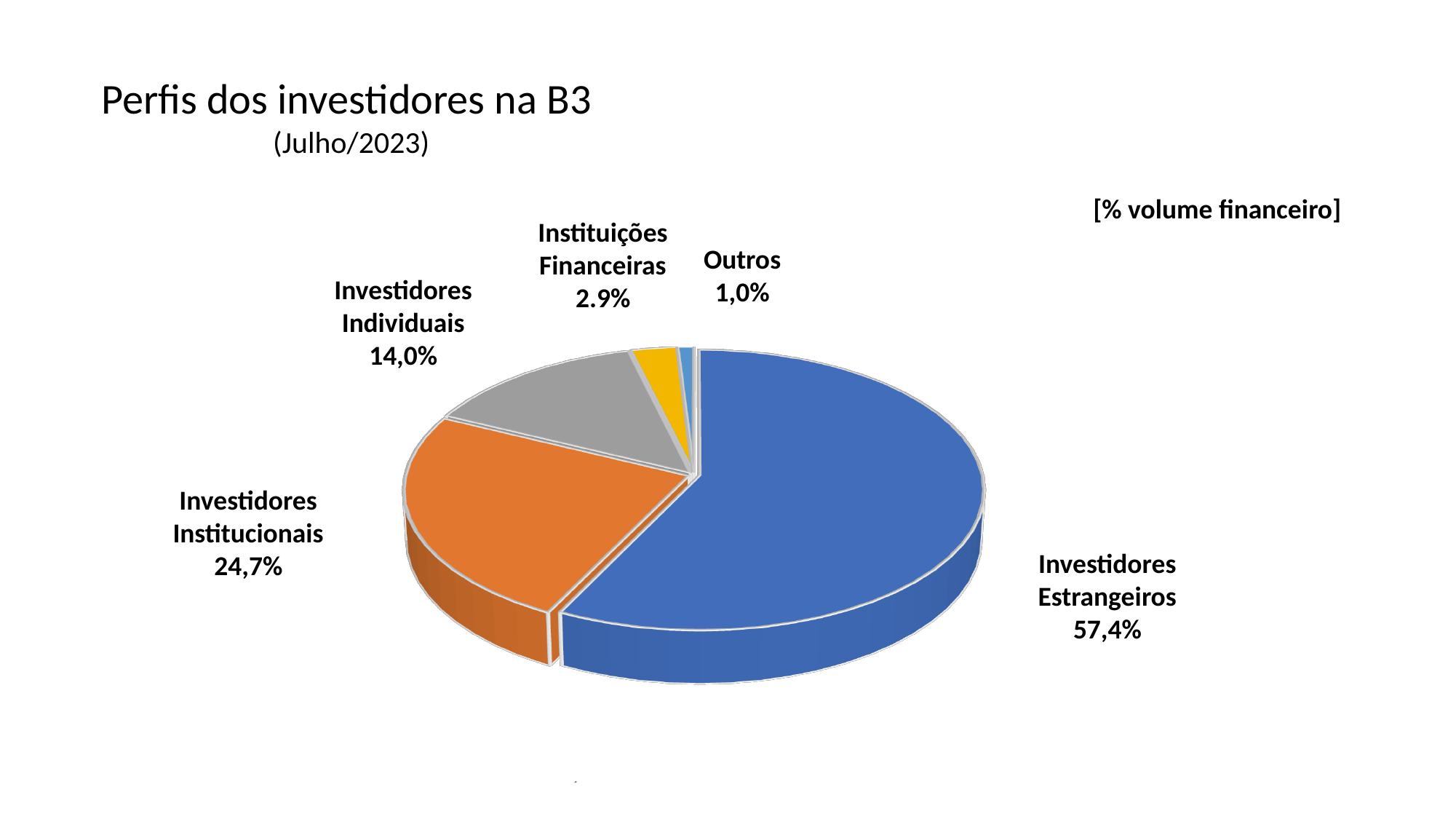
What is the value shown for Investidores Institucionais? 24,7% Which category has the largest slice of the pie? Investidores Estrangeiros What kind of chart is shown on the slide? Pie chart Which category has the smallest slice of the pie? Outros Which is larger, Investidores Institucionais or Investidores Individuais? Investidores Institucionais What is the value shown for Outros? 1,0% What share of the pie does Investidores Estrangeiros hold? 57,4% How many categories are shown in the pie chart? 5 What is the difference in percentage points between Investidores Estrangeiros and Investidores Institucionais? 32,7 What is the value shown for Instituições Financeiras? 2.9% What is the title of the chart? Perfis dos investidores na B3 (Julho/2023) What is the value shown for Investidores Individuais? 14,0%